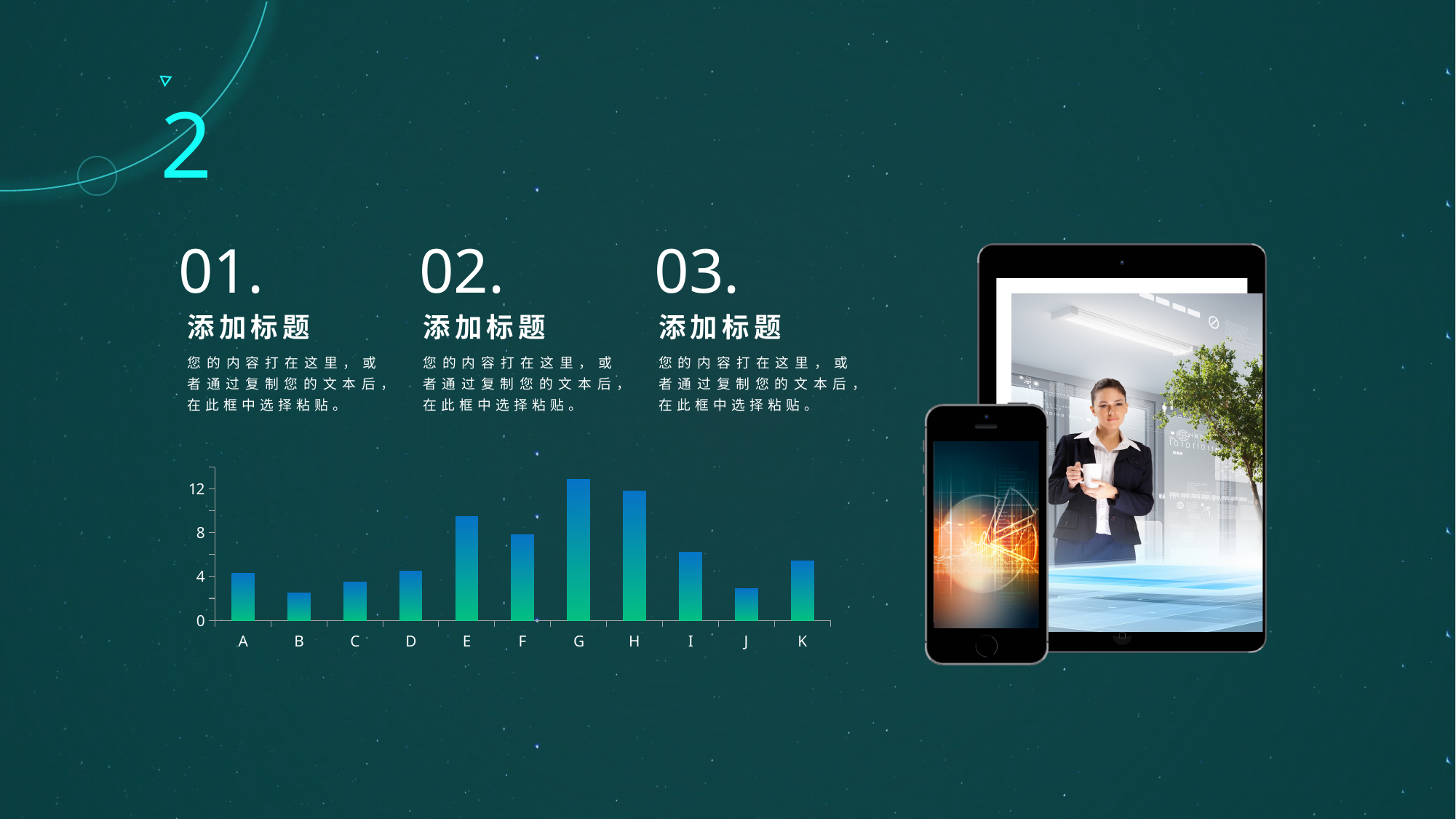
Which category has the highest bar in the chart? G Is the value for B greater or less than 4? less What kind of chart is shown on the slide? bar chart Which is larger, the value for H or the value for I? H What is the highest tick value shown on the y axis of the chart? 12 Which is larger, the value for E or the value for F? E How many categories are plotted on the x axis of the bar chart? 11 Is the value for E greater or less than 8? greater Is the value for I greater or less than 4? greater